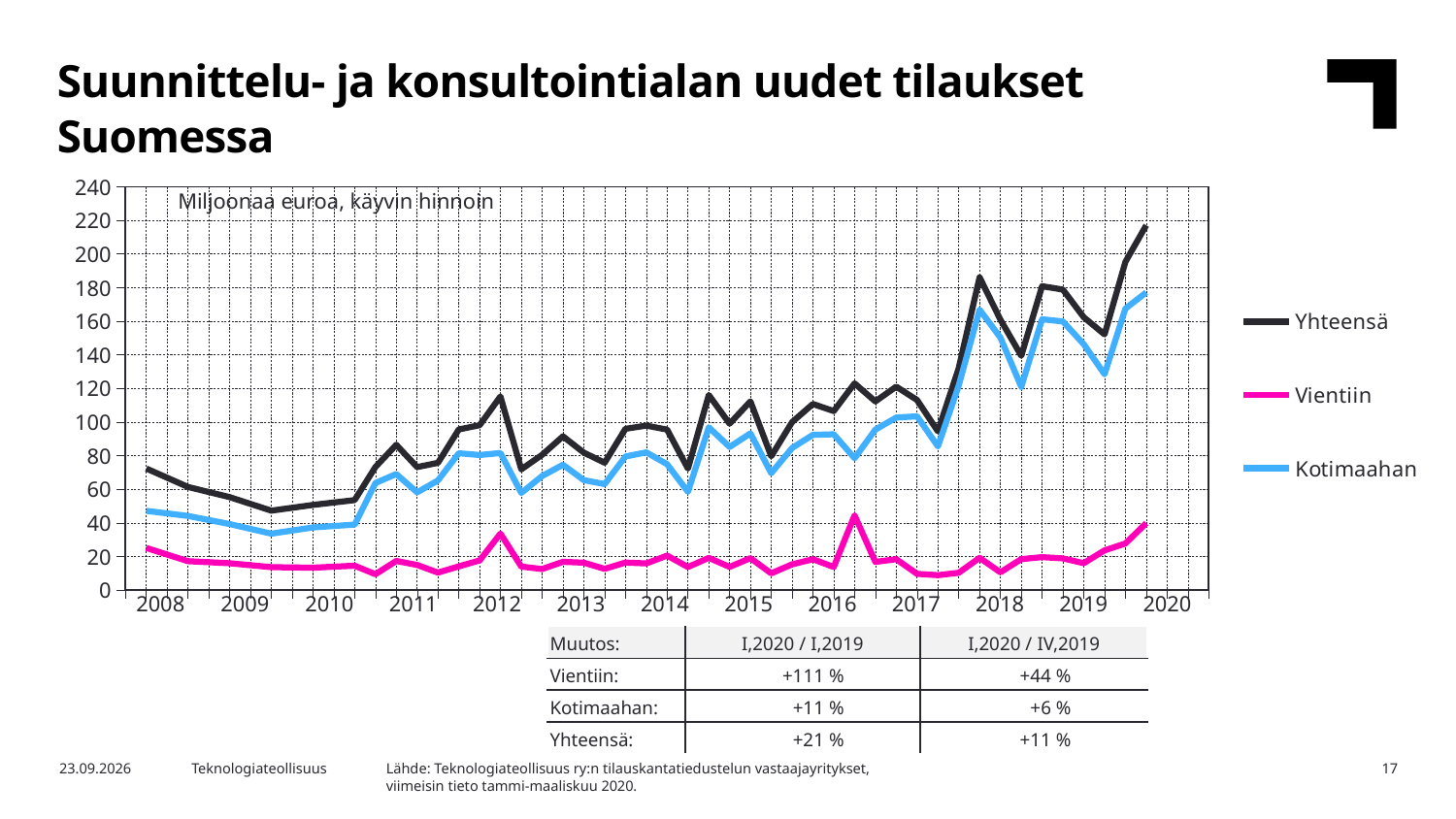
Is the value for Yhteensä at the start of 2008 greater or less than 60? greater Is the value for Vientiin at the start of 2008 greater or less than 40? less What kind of chart is shown on the slide? Line chart Is the value for Yhteensä at the last point (2020) greater or less than 200? greater Which series has the lowest values throughout the chart? Vientiin How many year labels are shown on the x axis? 13 What unit label is shown inside the chart area? Miljoonaa euroa, käyvin hinnoin Which series has the highest values throughout the chart? Yhteensä Does the Yhteensä series overall rise or fall from 2008 to 2020? rise How many series does the legend list? 3 What is the title of the chart? Suunnittelu- ja konsultointialan uudet tilaukset Suomessa